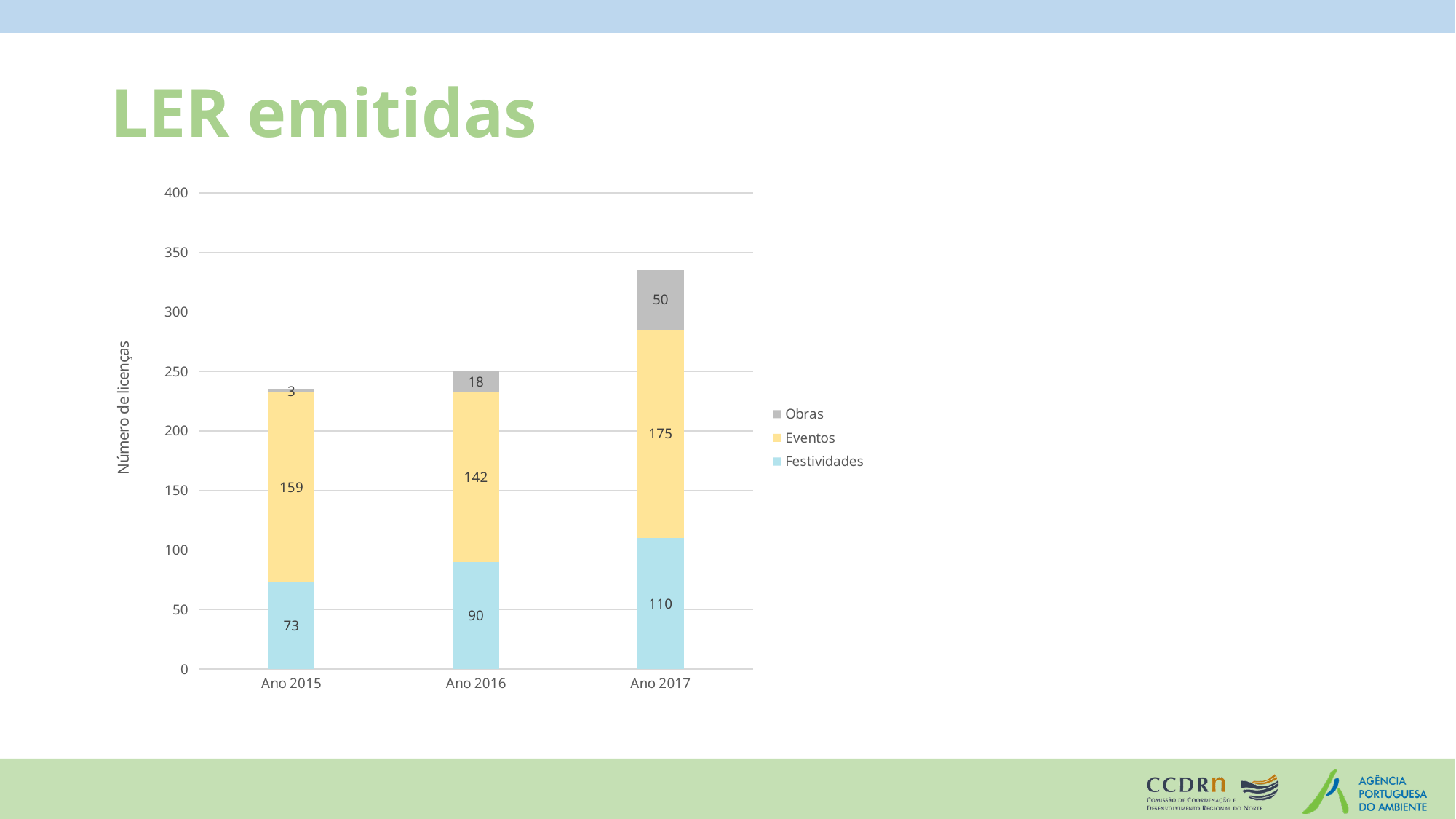
What is the total of the stacked bar for Ano 2017? 335 Which year has the highest value for Obras? Ano 2017 What is the difference between the Eventos values for Ano 2017 and Ano 2015? 16 What is the value for Obras in Ano 2015? 3 Which year has the lowest value for Festividades? Ano 2015 What is the value for Eventos in Ano 2016? 142 How many years are shown on the x axis? 3 What is the value for Festividades in Ano 2017? 110 How many series does the legend list? 3 Which is larger, Festividades in Ano 2016 or Obras in Ano 2017? Festividades in Ano 2016 What is the total of the stacked bar for Ano 2016? 250 Do the Festividades values rise or fall from Ano 2015 to Ano 2017? rise